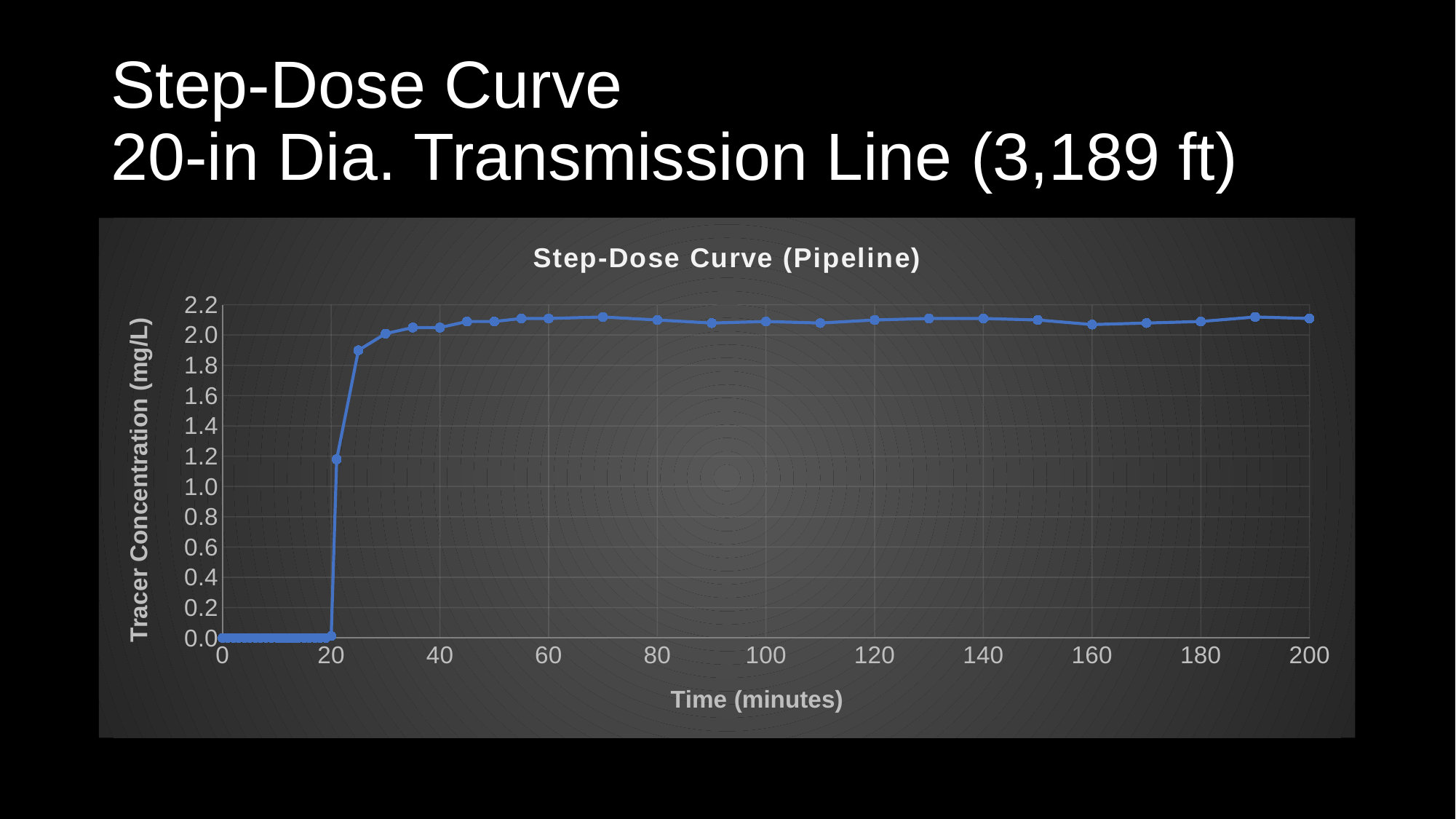
Which is larger, the tracer concentration at 20 minutes or at 100 minutes? 100 minutes Between 20 and 30 minutes, does the tracer concentration rise or fall? rise Is the tracer concentration at 100 minutes greater or less than 2.0? greater What kind of chart is shown on the slide? line chart Is the tracer concentration at 15 minutes greater or less than 0.2? less What is the label of the vertical axis? Tracer Concentration (mg/L) Is the tracer concentration at 25 minutes greater or less than 1.8? greater Which is larger, the tracer concentration at 20 minutes or at 25 minutes? 25 minutes What is the tracer concentration at 10 minutes? 0.0 What is the title printed inside the chart area? Step-Dose Curve (Pipeline)